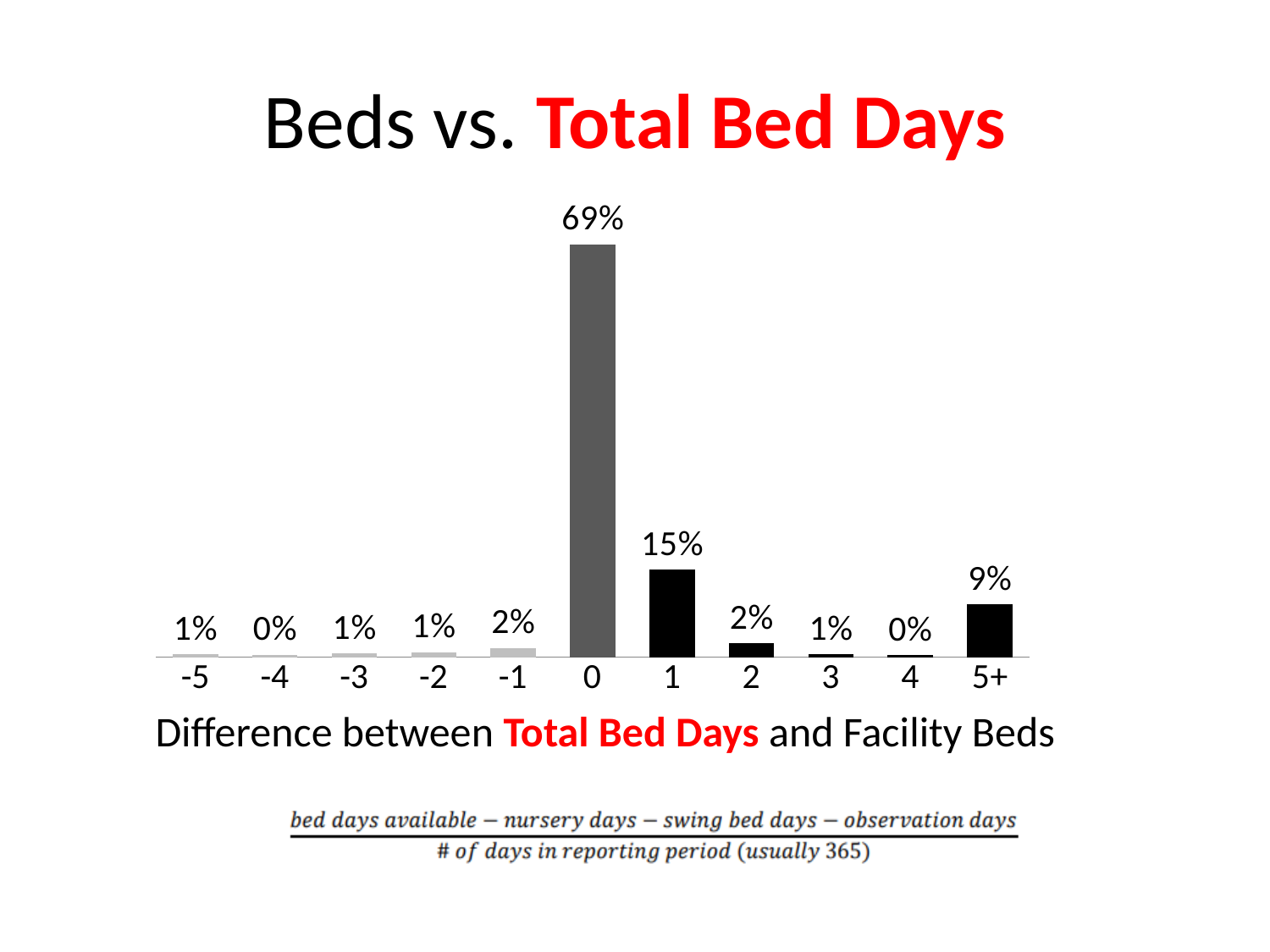
What kind of chart is shown on the slide? Bar chart What is the difference in percentage points between the 0 category and the 1 category? 54% How many categories are shown on the x axis? 11 Which category has the highest percentage? 0 What percentage is shown for a difference of -1? 2% What is the x-axis label of the chart? Difference between Total Bed Days and Facility Beds What percentage is shown for a difference of 1? 15% What is the difference in percentage points between the 1 category and the 5+ category? 6% What percentage is shown for a difference of 0 between Total Bed Days and Facility Beds? 69% What is the title of the slide? Beds vs. Total Bed Days What percentage is shown for the 5+ category? 9% Which is larger, the value for 2 or the value for 5+? 5+